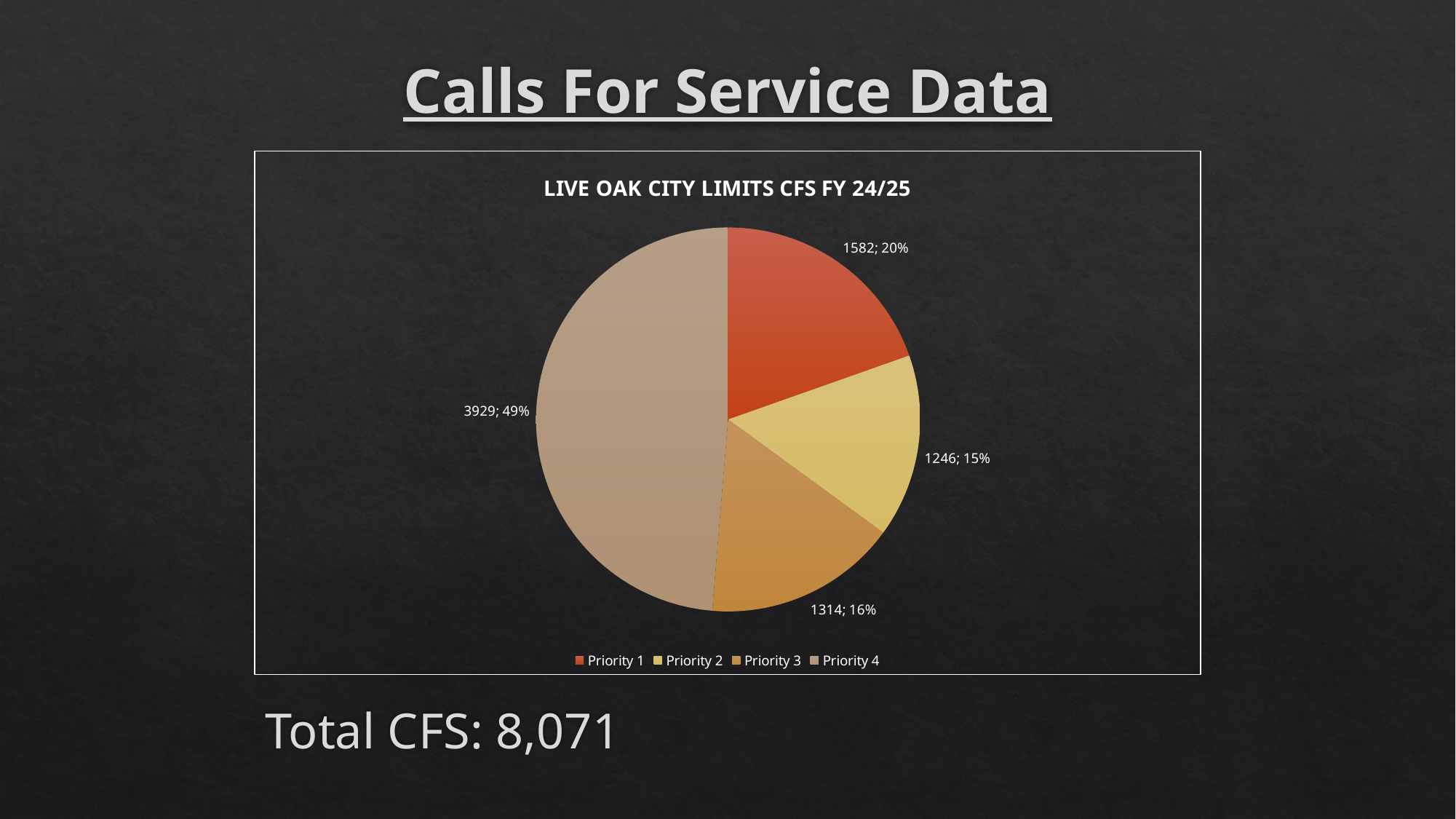
What is the difference between the values for Priority 4 and Priority 1? 2347 What is the title of the chart? LIVE OAK CITY LIMITS CFS FY 24/25 What is the value for Priority 2? 1246 What type of chart is shown on the slide? Pie chart How many slices does the pie chart have? 4 Which priority has the smallest share of the pie? Priority 2 How many entries does the legend list? 4 What is the value for Priority 4? 3929 What is the value for Priority 3? 1314 What is the value for Priority 1? 1582 What percentage share of the pie does Priority 4 have? 49% Which priority has the largest share of the pie? Priority 4